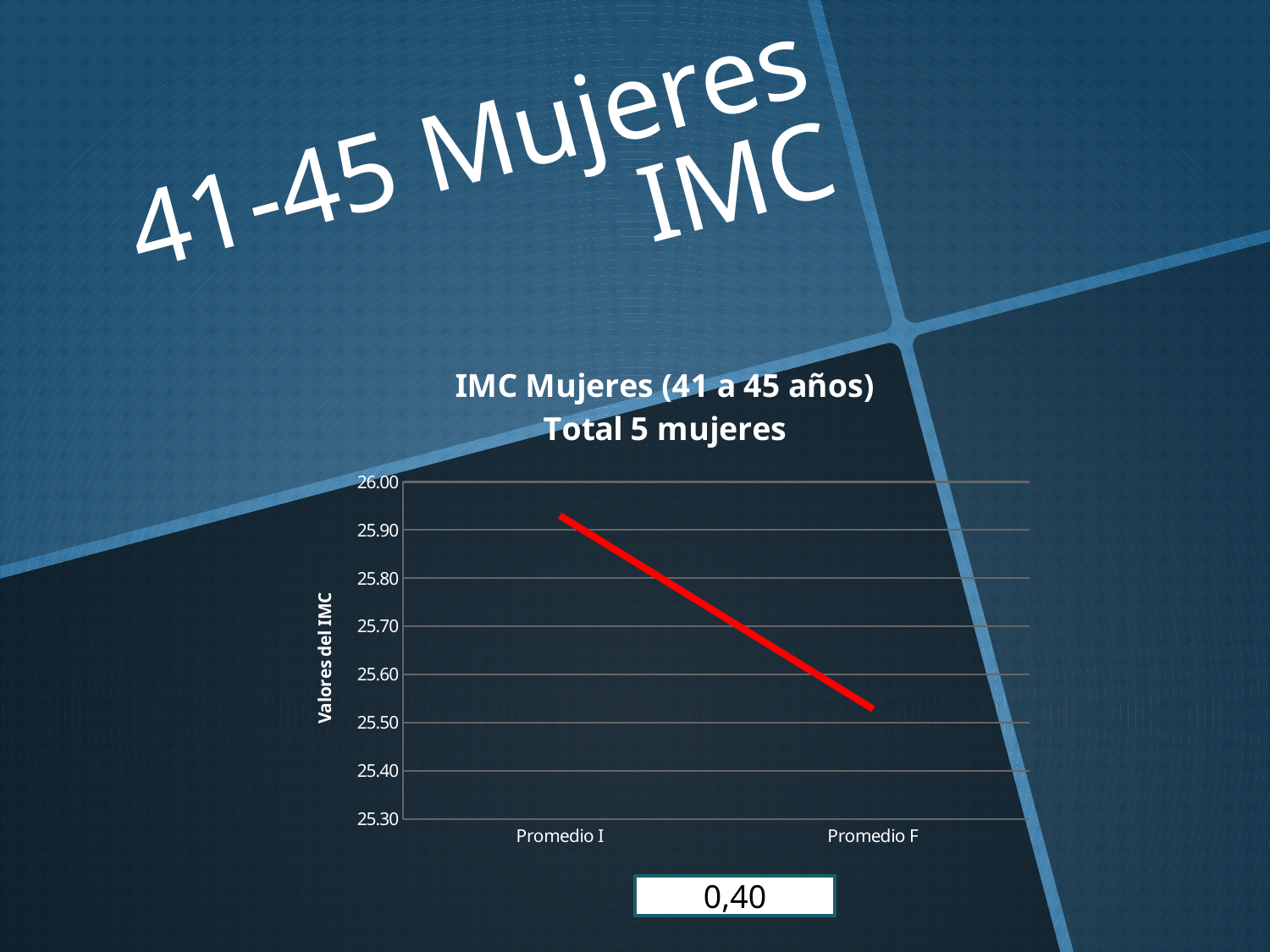
Which category has the lowest value? Promedio F Is the value for Promedio F greater or less than 25.40? greater Which category has the highest value, Promedio I or Promedio F? Promedio I Is the value for Promedio F greater or less than 25.60? less Do the values rise or fall from Promedio I to Promedio F? fall Is the value for Promedio I larger or smaller than the value for Promedio F? larger What is the title of the chart? IMC Mujeres (41 a 45 años) Total 5 mujeres What kind of chart is shown on the slide? line chart How many points are plotted on the line? 2 Is the value for Promedio I greater or less than 25.80? greater What is the label of the vertical axis? Valores del IMC